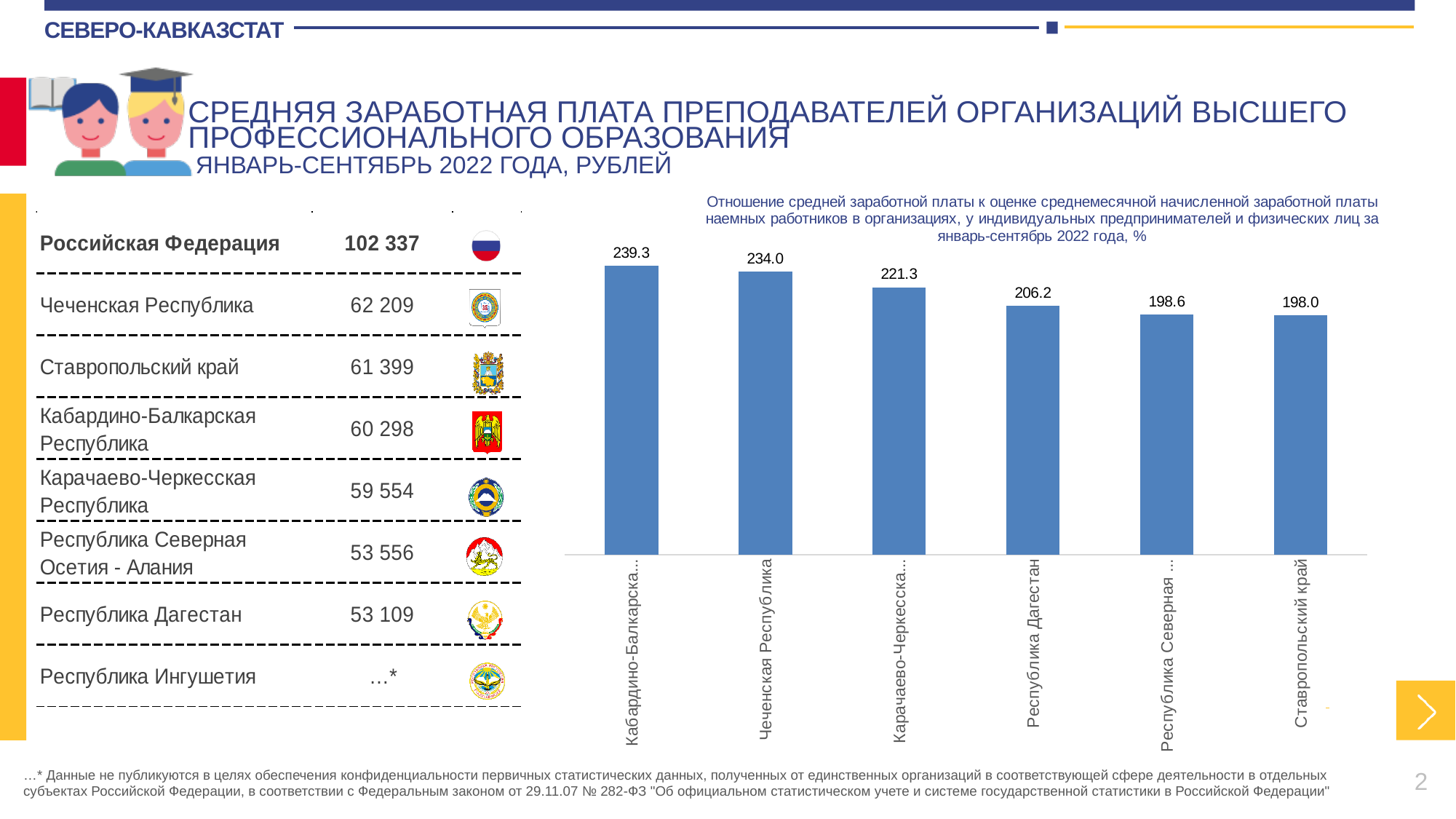
How many bars (regions) does the chart show? 6 What is the value for Республика Дагестан in the chart? 206.2 What is the value for the Кабардино-Балкарская bar in the chart? 239.3 What is the value for Ставропольский край in the chart? 198.0 What unit is stated in the chart title for the values shown? % What type of chart is shown on the slide? bar chart Which region has the highest value in the chart? Кабардино-Балкарская Республика What is the difference between the values for Чеченская Республика and Республика Дагестан? 27.8 Which is larger in the chart: the value for Карачаево-Черкесская or for Республика Дагестан? Карачаево-Черкесская What is the value for Чеченская Республика in the chart? 234.0 Do the values in the chart rise or fall from left to right? fall Which region has the lowest value in the chart? Ставропольский край